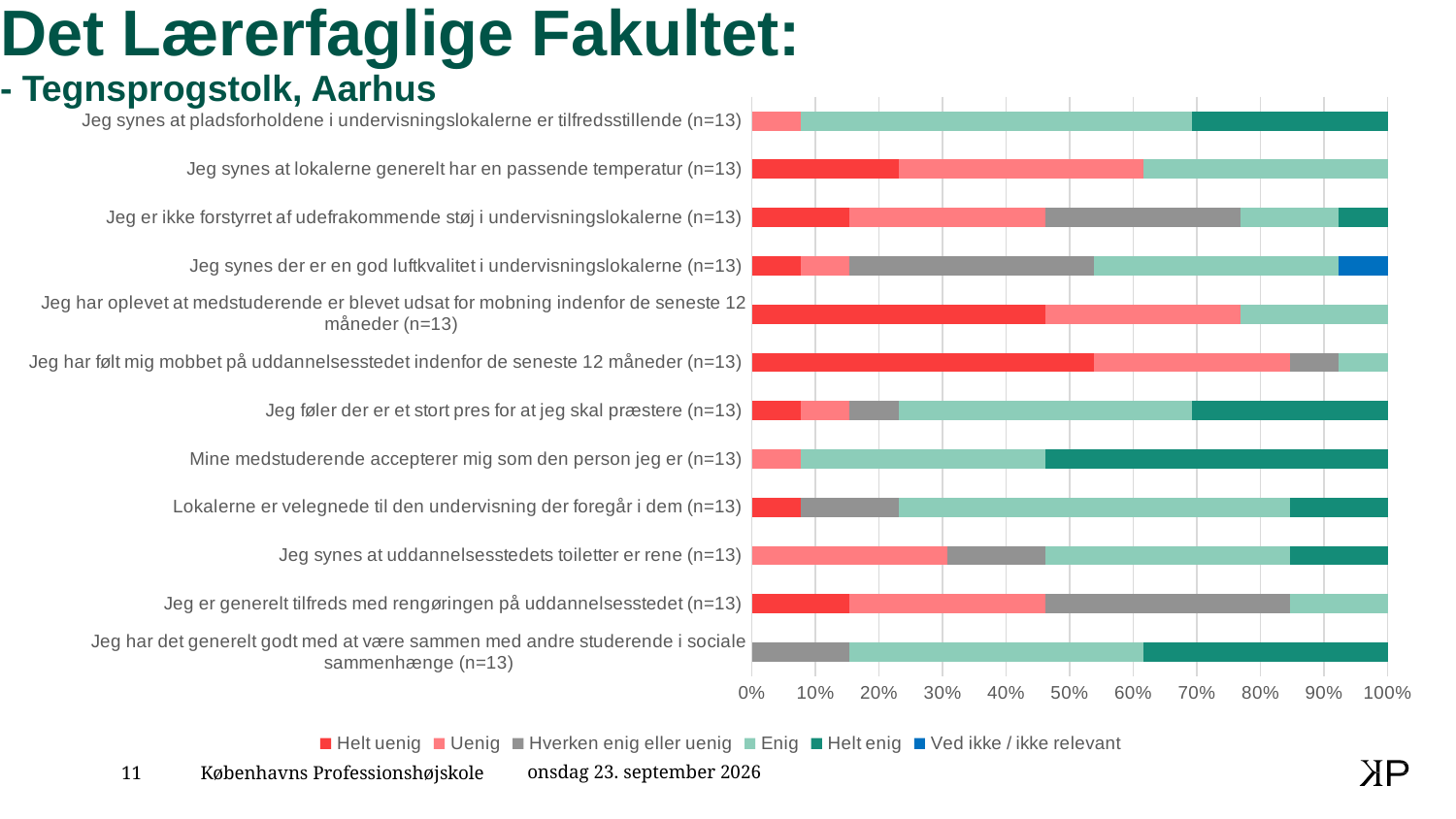
How many statements (categories) are plotted in the chart? 12 What kind of chart is shown on the slide? Stacked bar chart Which has the larger 'Helt enig' segment: 'Mine medstuderende accepterer mig som den person jeg er' or 'Jeg synes at pladsforholdene i undervisningslokalerne er tilfredsstillende'? Mine medstuderende accepterer mig som den person jeg er What is the number of respondents (n) shown for each statement? 13 Is the 'Helt uenig' share for 'Jeg synes at lokalerne generelt har en passende temperatur' greater or less than 10%? greater Is the 'Helt uenig' share for 'Jeg har følt mig mobbet på uddannelsesstedet indenfor de seneste 12 måneder' greater or less than 40%? greater Is the 'Enig' share for 'Jeg synes at pladsforholdene i undervisningslokalerne er tilfredsstillende' greater or less than 50%? greater How many series does the legend list? 6 What does each stacked bar in the chart total? 100% Which colour represents 'Ved ikke / ikke relevant' in the legend? Blue Which statement has the largest 'Helt enig' segment? Mine medstuderende accepterer mig som den person jeg er (n=13)